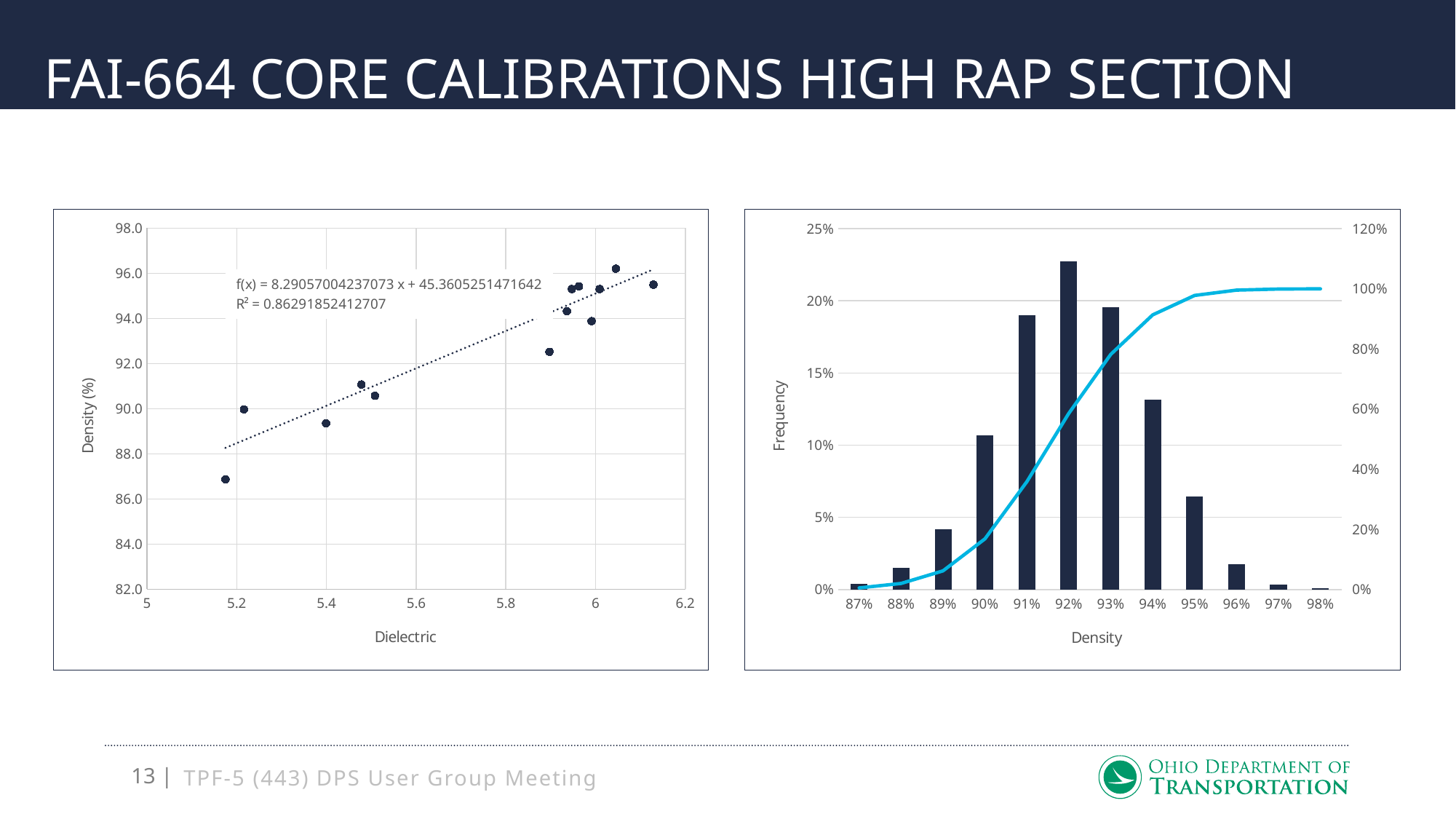
In the right chart, which density category has the highest frequency bar? 92% In the left chart, what is the R² value printed for the trendline? 0.86291852412707 What kind of chart is the left chart on the slide? scatter plot In the right chart, which has the larger frequency bar, 88% or 89%? 89% What kind of chart is the right chart on the slide (the one with the Frequency axis)? bar chart with a line In the right chart, is the frequency for 92% greater or less than 20%? greater In the right chart, which has the larger frequency bar, 91% or 94%? 91% In the right chart, is the frequency for 89% greater or less than 5%? less In the right chart, is the frequency for 94% greater or less than 10%? greater In the right chart, which density category has the lowest frequency bar? 98% In the right chart, how many density categories are shown on the x axis? 12 In the left chart, what is the label of the x axis? Dielectric